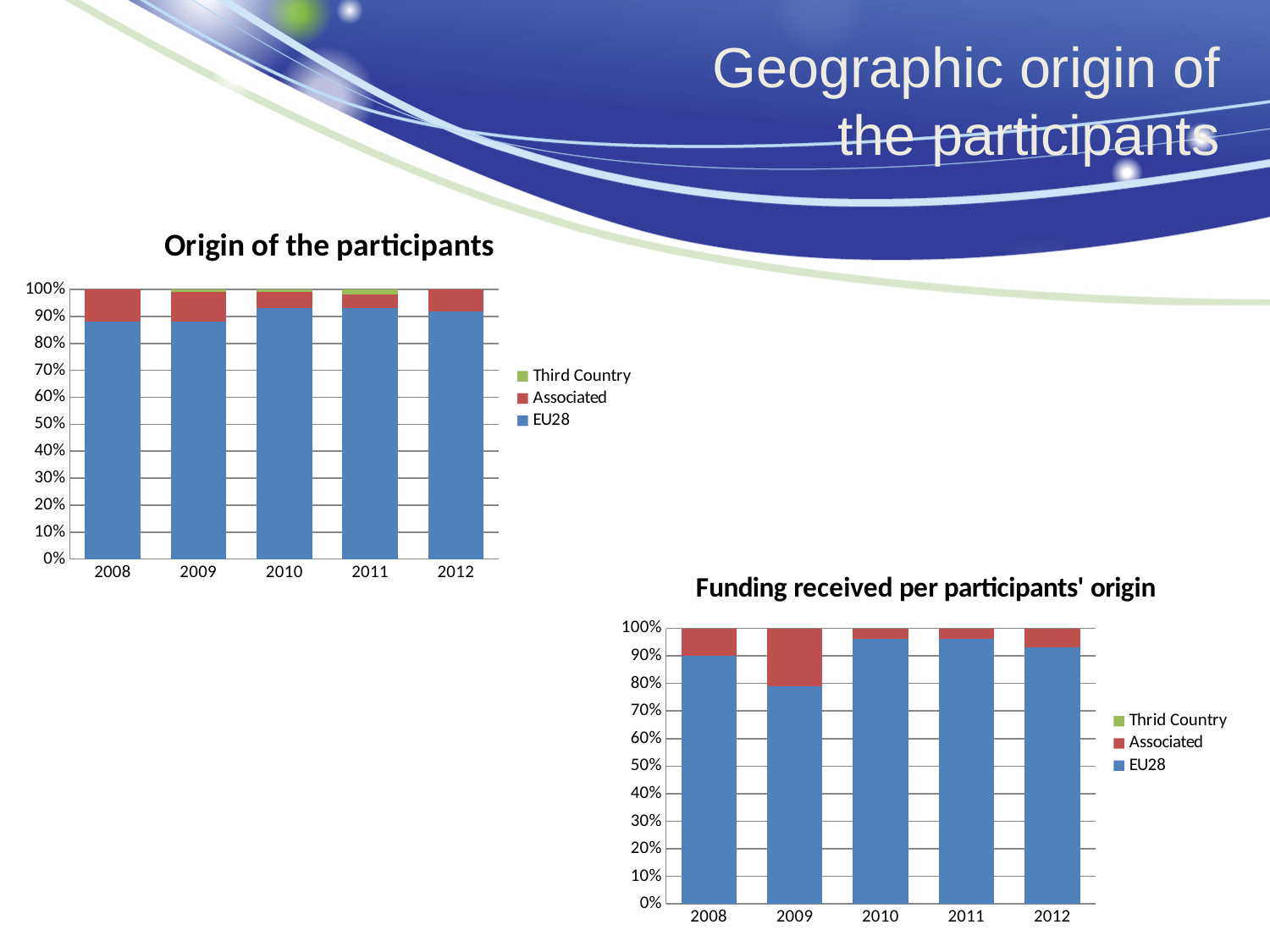
How many series does the legend of the 'Funding received per participants' origin' chart list? 3 In the 'Funding received per participants' origin' chart, which year has the lowest EU28 share? 2009 In the 'Origin of the participants' chart, which year has the larger EU28 share, 2008 or 2010? 2010 How many years are shown on the x axis of the 'Origin of the participants' chart? 5 In the 'Funding received per participants' origin' chart, is the EU28 share for 2010 greater or less than 90%? greater In the 'Funding received per participants' origin' chart, which year has the larger EU28 share, 2008 or 2009? 2008 In the 'Origin of the participants' chart, is the EU28 share for 2010 greater or less than 90%? greater Which colour represents EU28 in the 'Origin of the participants' chart? blue In the 'Funding received per participants' origin' chart, is the EU28 share for 2009 greater or less than 90%? less In the 'Funding received per participants' origin' chart, which year has the largest Associated share? 2009 What type of chart is the 'Origin of the participants' chart? stacked bar chart